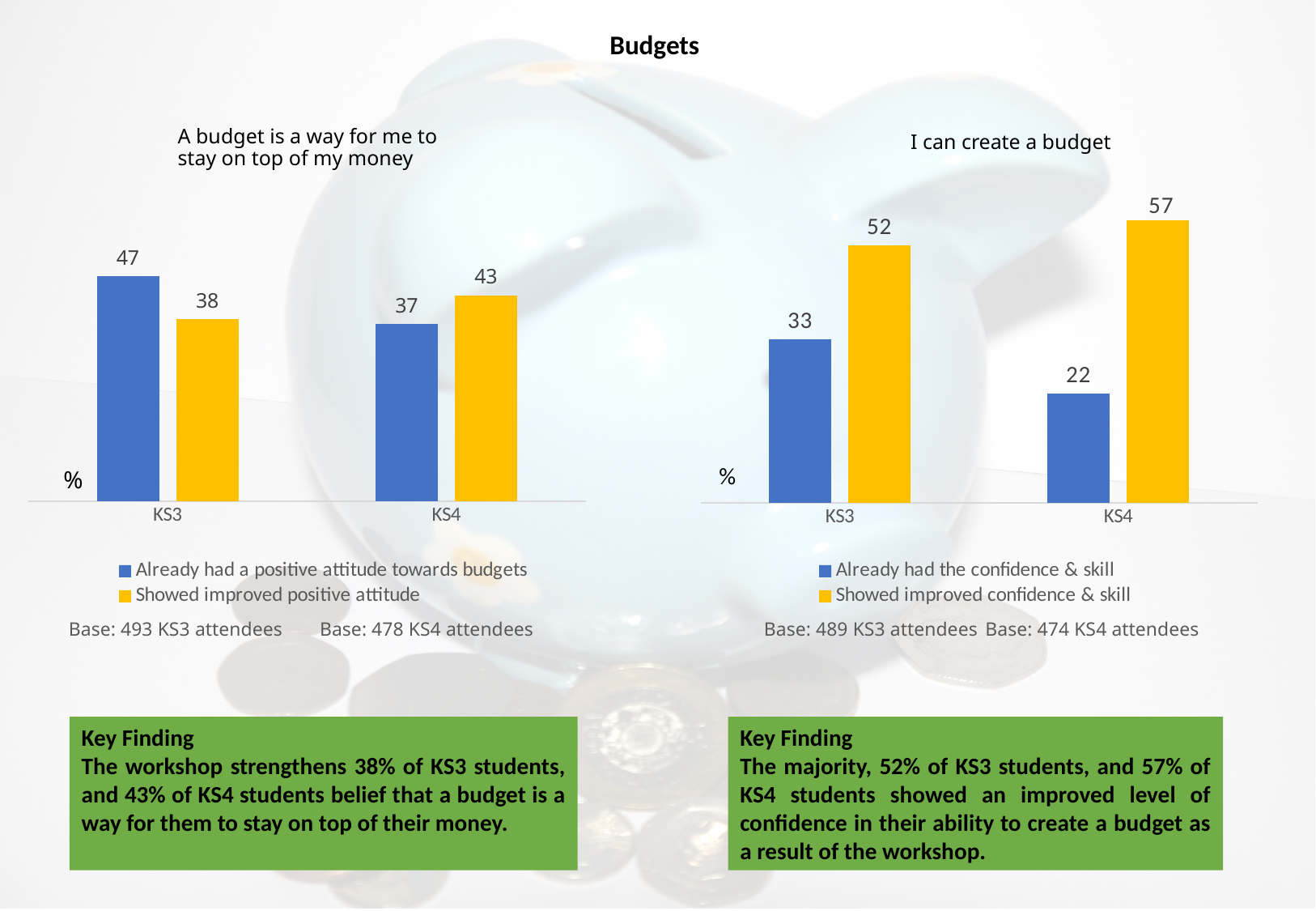
What kind of chart is the chart titled 'I can create a budget'? Bar chart How many categories are shown on the x axis of the chart titled 'A budget is a way for me to stay on top of my money'? 2 In the chart titled 'A budget is a way for me to stay on top of my money', what is the value for 'Showed improved positive attitude' for KS4? 43 In the chart titled 'A budget is a way for me to stay on top of my money', what is the value for 'Already had a positive attitude towards budgets' for KS3? 47 In the chart titled 'I can create a budget', what is the value for 'Already had the confidence & skill' for KS4? 22 In the chart titled 'A budget is a way for me to stay on top of my money', what is the difference between the two KS3 bars? 9 In the chart titled 'I can create a budget', what is the difference between the two KS4 bars? 35 In the chart titled 'I can create a budget', what is the value for 'Showed improved confidence & skill' for KS3? 52 In the chart titled 'I can create a budget', which bar has the highest value? Showed improved confidence & skill, KS4 How many series does the legend list for the chart titled 'I can create a budget'? 2 In the chart titled 'A budget is a way for me to stay on top of my money', which bar has the lowest value? Already had a positive attitude towards budgets, KS4 In the chart titled 'I can create a budget', which is larger for KS3: 'Already had the confidence & skill' or 'Showed improved confidence & skill'? Showed improved confidence & skill